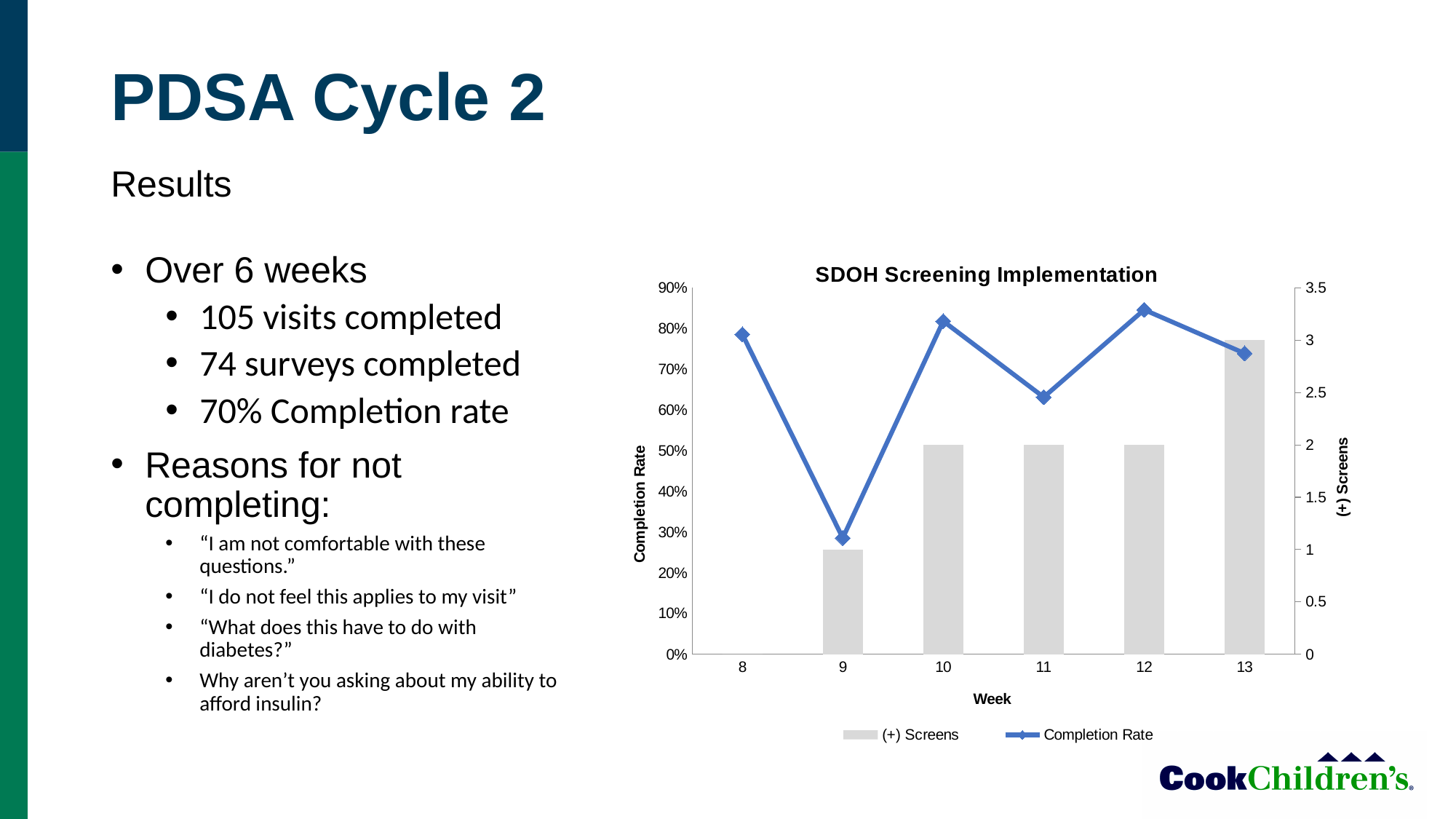
What is the title of the chart? SDOH Screening Implementation Is the Completion Rate for week 12 greater or less than 80%? greater What kind of chart is shown on the slide? Combination bar and line chart Which week has the highest number of (+) Screens? 13 What is the difference in (+) Screens between week 13 and week 9? 2 How many (+) Screens are shown for week 13? 3 Which week has the lowest Completion Rate? 9 How many series does the chart legend list? 2 Which week has a higher Completion Rate, week 10 or week 11? 10 How many weeks are plotted on the x axis of the chart? 6 Is the Completion Rate for week 9 greater or less than 40%? less How many (+) Screens are shown for week 9? 1